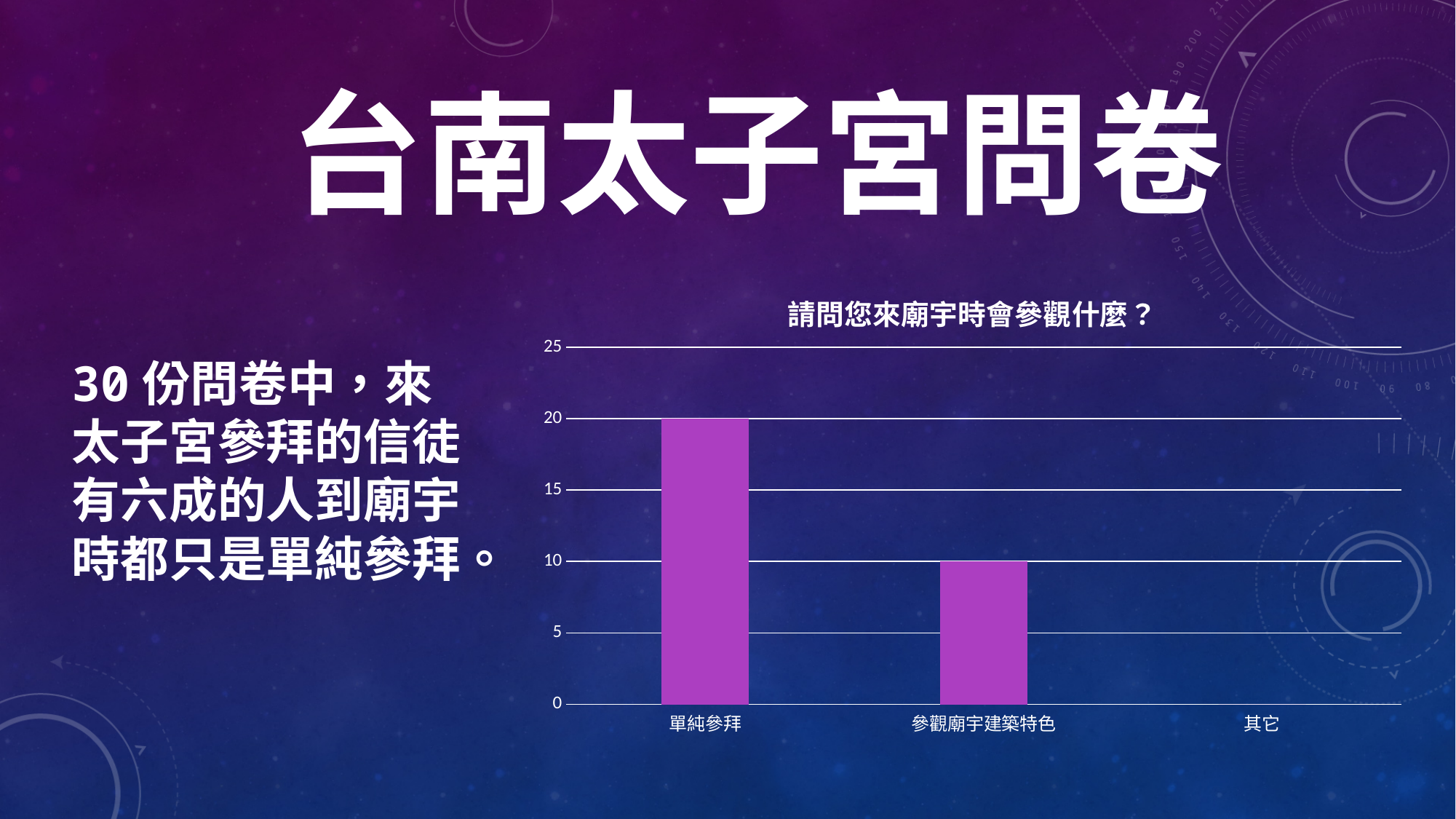
What kind of chart is shown on the slide? bar chart What is the value for 單純參拜? 20 Which category has the highest value? 單純參拜 What is the value for 其它? 0 Do the values rise or fall from left to right along the x axis? fall Is the value for 單純參拜 greater or less than 15? greater Which category has the lowest value? 其它 What is the difference between the values for 單純參拜 and 參觀廟宇建築特色? 10 Which is larger, the value for 單純參拜 or the value for 參觀廟宇建築特色? 單純參拜 What is the title of the chart? 請問您來廟宇時會參觀什麼？ What is the value for 參觀廟宇建築特色? 10 How many categories are shown on the x axis of the chart? 3